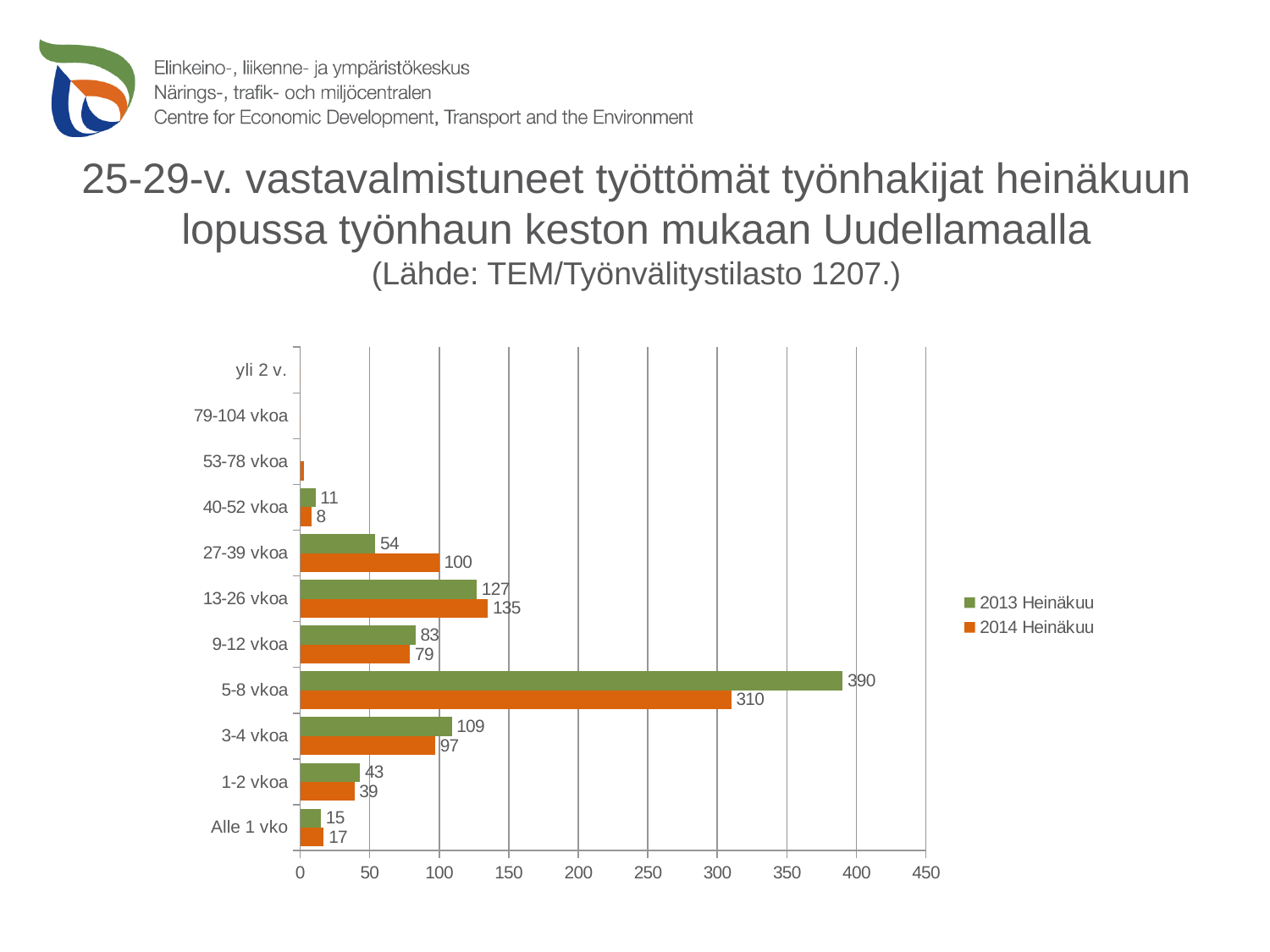
What is the difference between the 2013 Heinäkuu and 2014 Heinäkuu values for 5-8 vkoa? 80 What kind of chart is shown on the slide? bar chart What is the value for 5-8 vkoa in the 2013 Heinäkuu series? 390 What is the value for 27-39 vkoa in the 2014 Heinäkuu series? 100 What is the value for Alle 1 vko in the 2014 Heinäkuu series? 17 Is the value for 3-4 vkoa in the 2013 Heinäkuu series greater or less than 100? greater Which is larger for 13-26 vkoa: the 2013 Heinäkuu value or the 2014 Heinäkuu value? 2014 Heinäkuu How many series does the legend list? 2 Which category has the highest value in the 2014 Heinäkuu series? 5-8 vkoa How many categories are shown on the vertical axis of the chart? 11 What is the difference between the 2014 Heinäkuu and 2013 Heinäkuu values for 27-39 vkoa? 46 Which colour represents the 2014 Heinäkuu series in the chart? orange